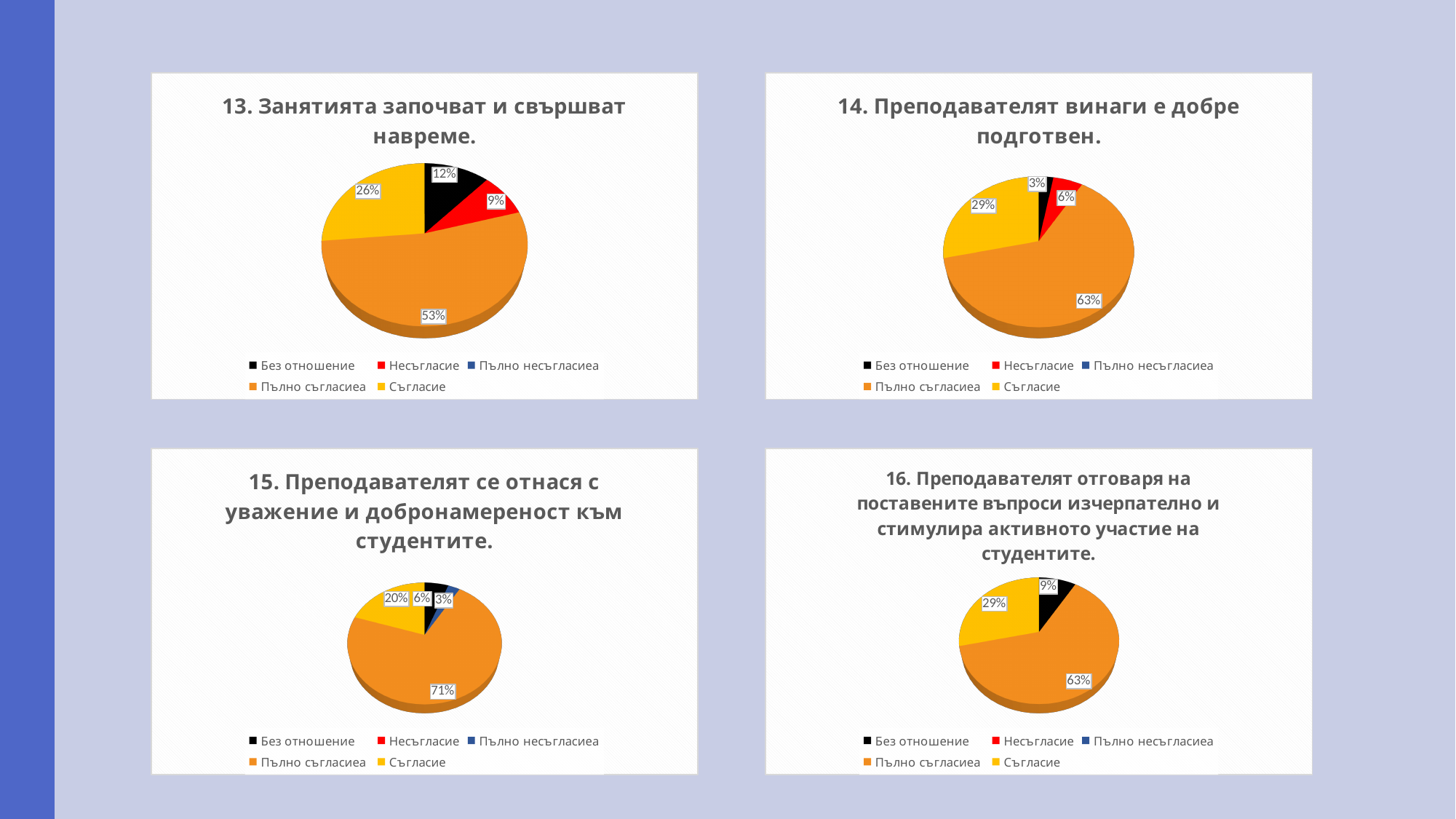
What type of chart is used in the top-left chart on the slide? Pie chart In the chart titled "13. Занятията започват и свършват навреме.", what is the difference between the Пълно съгласиеа and Съгласие percentages? 27% In the chart titled "14. Преподавателят винаги е добре подготвен.", which is larger, Несъгласие or Без отношение? Несъгласие In the chart titled "14. Преподавателят винаги е добре подготвен.", what percentage is shown for Съгласие? 29% In the chart titled "16. Преподавателят отговаря на поставените въпроси изчерпателно и стимулира активното участие на студентите.", which category has the largest slice? Пълно съгласиеа In the chart titled "14. Преподавателят винаги е добре подготвен.", which category has the smallest slice? Без отношение In the chart titled "15. Преподавателят се отнася с уважение и добронамереност към студентите.", what percentage is shown for Пълно несъгласиеа? 3% In the chart titled "13. Занятията започват и свършват навреме.", what percentage is shown for Пълно съгласиеа? 53% How many entries does the legend list in the chart titled "15. Преподавателят се отнася с уважение и добронамереност към студентите."? 5 In the chart titled "13. Занятията започват и свършват навреме.", what percentage is shown for Несъгласие? 9% In the chart titled "15. Преподавателят се отнася с уважение и добронамереност към студентите.", what percentage is shown for Пълно съгласиеа? 71% In the chart titled "16. Преподавателят отговаря на поставените въпроси изчерпателно и стимулира активното участие на студентите.", what percentage is shown for Без отношение? 9%